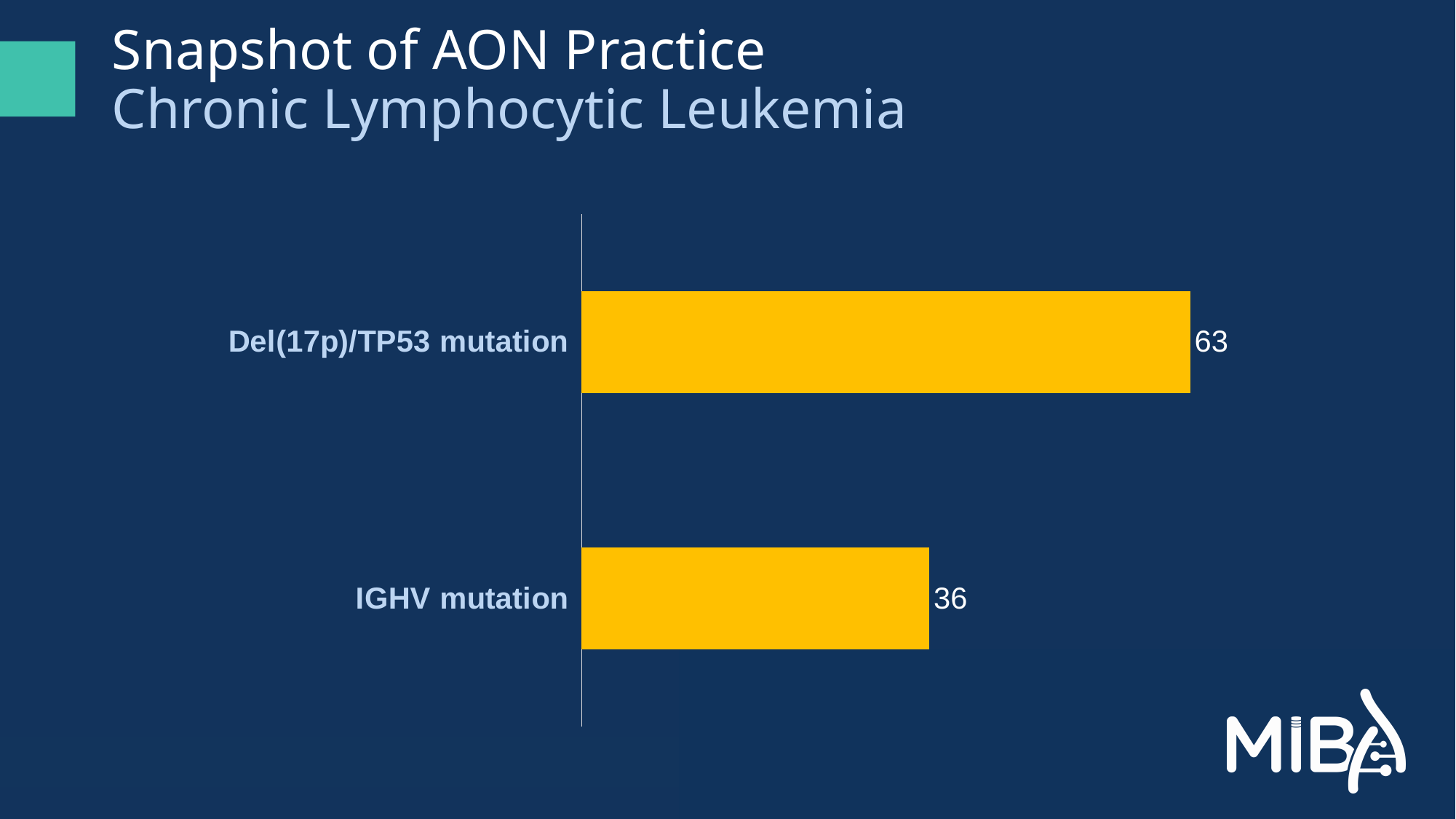
Are the bars in the chart horizontal or vertical? Horizontal How many categories are shown in the chart? 2 What is the difference between the values for Del(17p)/TP53 mutation and IGHV mutation? 27 What is the value for IGHV mutation? 36 Which category has the highest value? Del(17p)/TP53 mutation What is the total of the two values shown in the chart? 99 Which is larger, the value for Del(17p)/TP53 mutation or the value for IGHV mutation? Del(17p)/TP53 mutation What kind of chart is shown on the slide? Bar chart What is the value for Del(17p)/TP53 mutation? 63 What colour are the bars in the chart? Yellow Which category has the lowest value? IGHV mutation